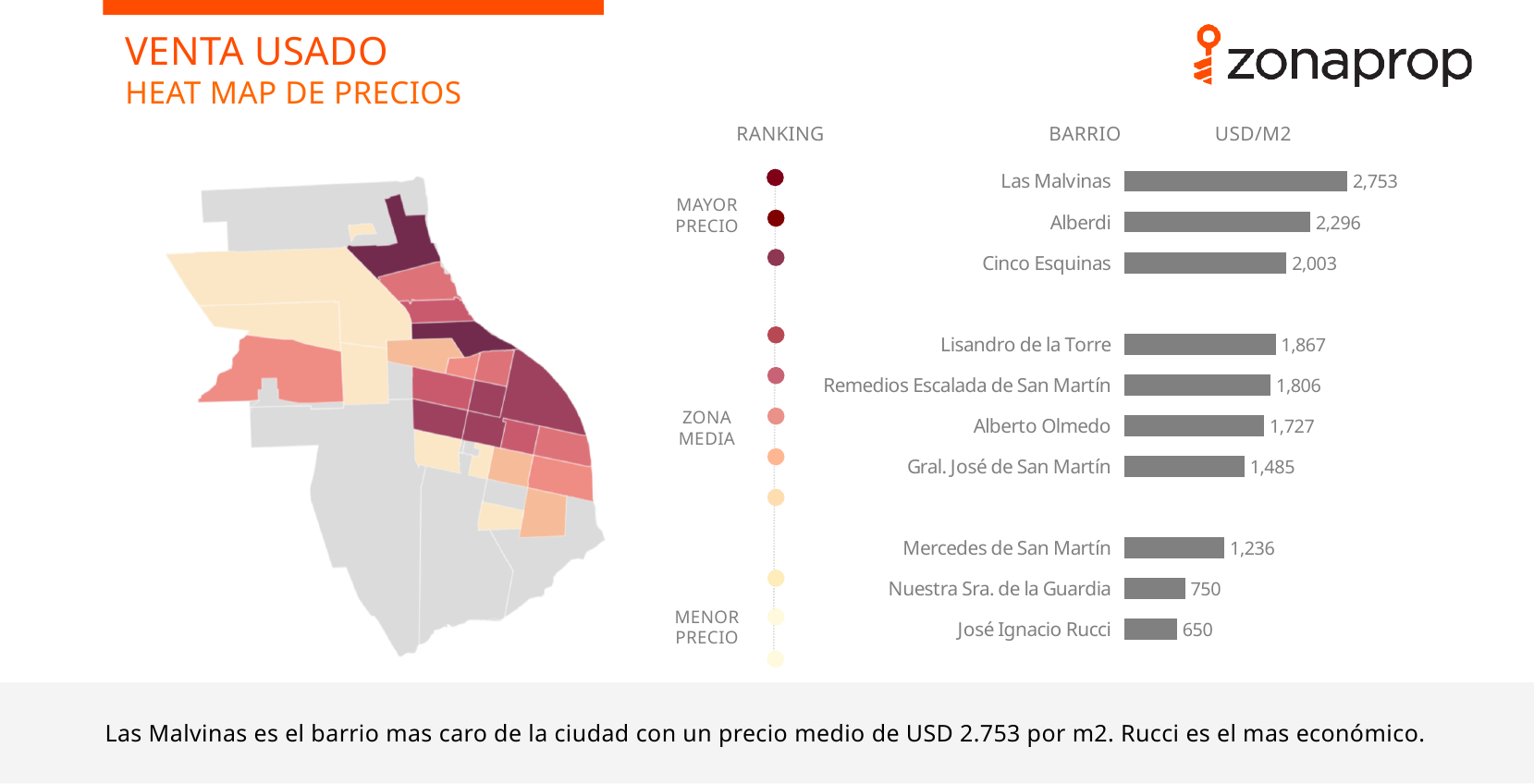
What is the subtitle of the slide below 'VENTA USADO'? HEAT MAP DE PRECIOS Which barrio has the lowest USD/M2 value? José Ignacio Rucci Which barrio has the highest USD/M2 value? Las Malvinas Which has a higher USD/M2 value, Lisandro de la Torre or Alberto Olmedo? Lisandro de la Torre What kind of chart shows the USD/M2 values by barrio? Bar chart How many barrios are shown in the bar chart? 10 What is the USD/M2 value for Gral. José de San Martín? 1,485 What is the USD/M2 value for Nuestra Sra. de la Guardia? 750 What is the USD/M2 value for Alberdi? 2,296 Which has a higher USD/M2 value, Mercedes de San Martín or Cinco Esquinas? Cinco Esquinas What is the difference in USD/M2 between Las Malvinas and Alberdi? 457 What is the difference in USD/M2 between Nuestra Sra. de la Guardia and José Ignacio Rucci? 100